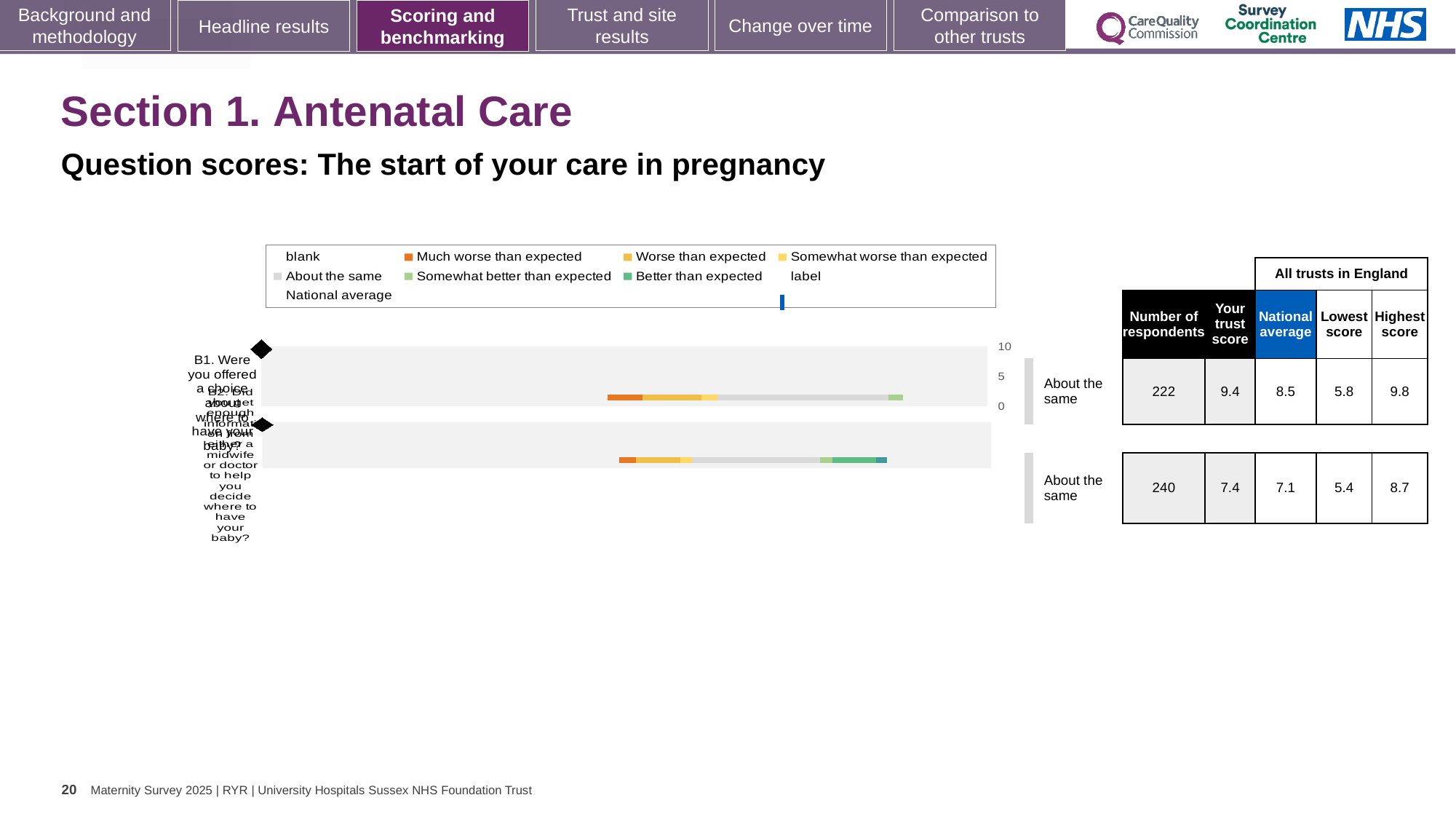
In the table beside the chart, what is the national average for B2? 7.1 By how much does the trust score for B1 exceed the national average for B1? 0.9 What is the difference between the highest score and the lowest score for B2? 3.3 Which question has the higher national average, B1 or B2? B1 Which question has the higher trust score, B1 or B2? B1 In the table beside the chart, what is the number of respondents for B2? 240 In the table beside the chart, what is the number of respondents for B1 (Were you offered a choice about where to have your baby?)? 222 What colour does the legend use for 'Much worse than expected'? orange How many questions (bars) are plotted in the chart? 2 What kind of chart is shown on the slide? bar chart In the table beside the chart, what is the highest score in England for B1? 9.8 In the table beside the chart, what is the trust score for B1? 9.4